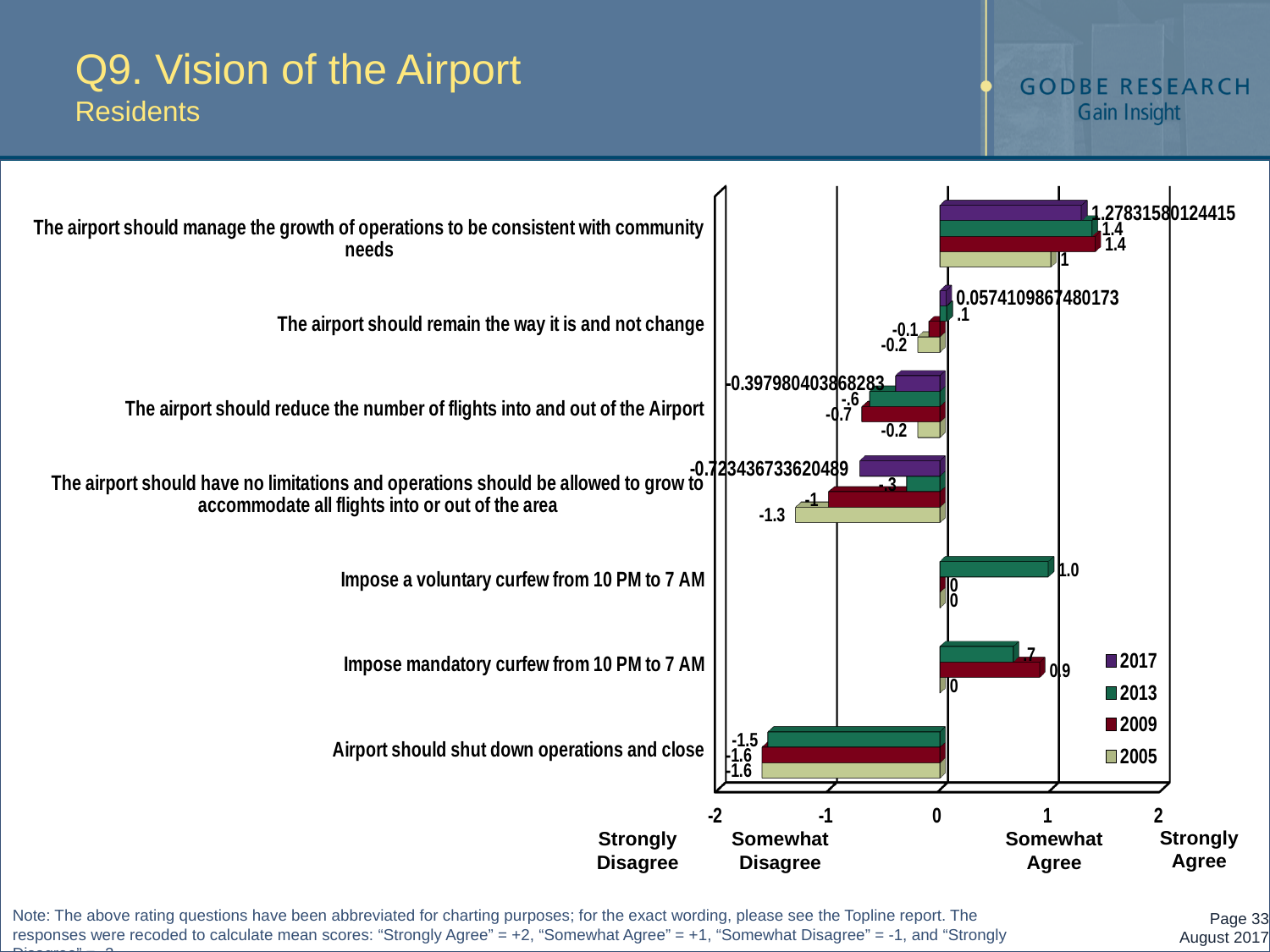
For "The airport should reduce the number of flights into and out of the Airport", which is larger: the 2009 value or the 2005 value? 2005 Which statement has the lowest 2005 value? Airport should shut down operations and close Which years are listed in the chart legend? 2017, 2013, 2009, 2005 What is the 2005 value for "The airport should have no limitations and operations should be allowed to grow to accommodate all flights into or out of the area"? -1.3 How many statements (categories) are plotted on the chart? 7 What is the 2005 value for "Airport should shut down operations and close"? -1.6 How many series does the legend list? 4 What is the difference between the 2013 value and the 2005 value for "The airport should manage the growth of operations to be consistent with community needs"? 0.4 What is the 2013 value for "Impose a voluntary curfew from 10 PM to 7 AM"? 1.0 What kind of chart is shown on the slide? bar chart Which statement has the highest 2013 value? The airport should manage the growth of operations to be consistent with community needs What is the 2009 value for "Impose mandatory curfew from 10 PM to 7 AM"? 0.9